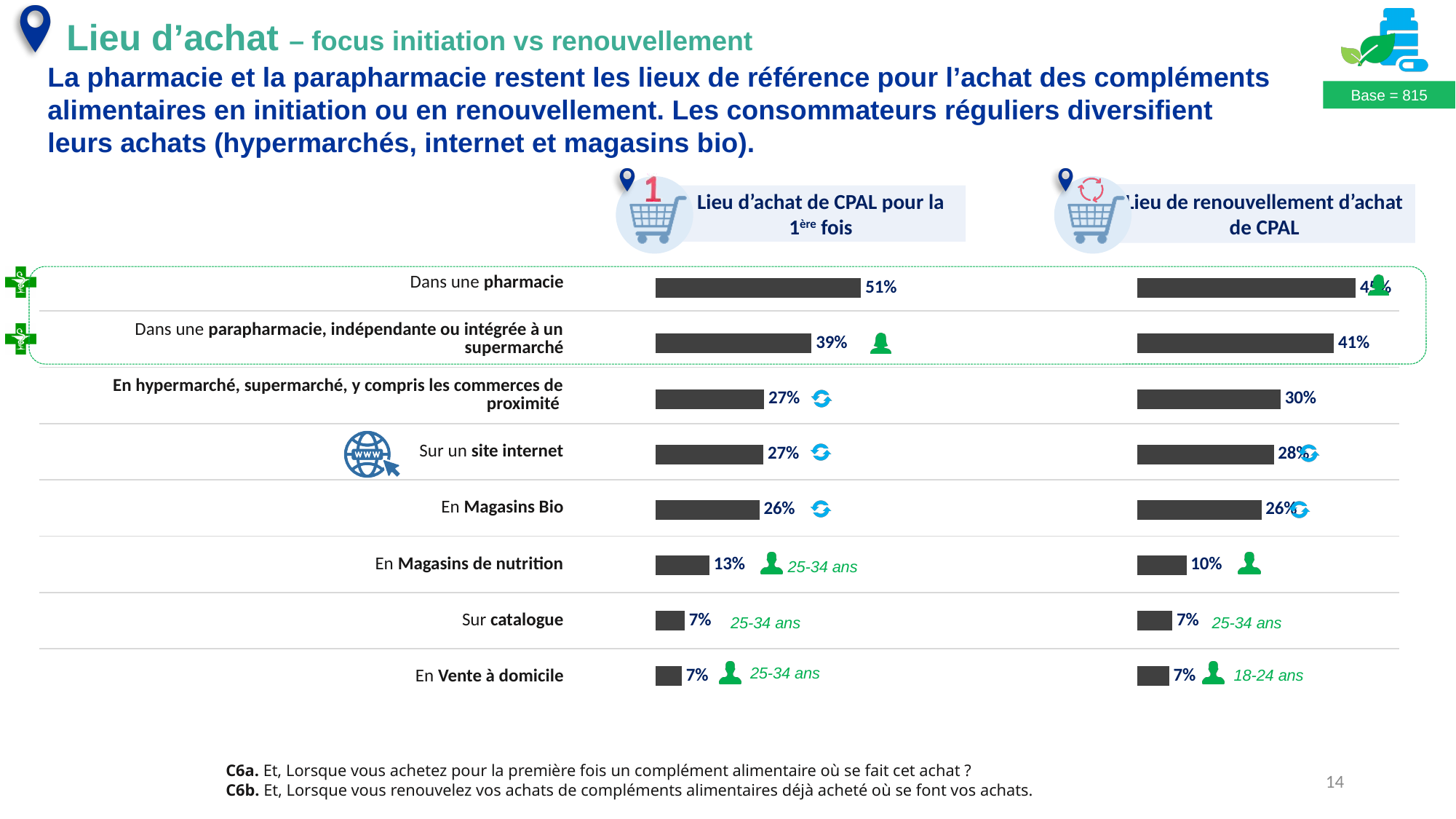
How many categories are shown in the 'Lieu d'achat de CPAL pour la 1ère fois' chart? 8 In the 'Lieu d'achat de CPAL pour la 1ère fois' chart, which category has the highest value? Dans une pharmacie In the 'Lieu d'achat de CPAL pour la 1ère fois' chart, what is the difference between 'Dans une pharmacie' and 'Dans une parapharmacie, indépendante ou intégrée à un supermarché'? 12% In the 'Lieu d'achat de CPAL pour la 1ère fois' chart, what is the value for 'Dans une pharmacie'? 51% In the 'Lieu de renouvellement d'achat de CPAL' chart, what is the value for 'En hypermarché, supermarché, y compris les commerces de proximité'? 30% In the 'Lieu de renouvellement d'achat de CPAL' chart, what is the difference between 'Sur un site internet' and 'En Magasins de nutrition'? 18% In the 'Lieu d'achat de CPAL pour la 1ère fois' chart, what is the value for 'En Magasins de nutrition'? 13% Which is larger: 'En hypermarché, supermarché, y compris les commerces de proximité' in the 'Lieu d'achat de CPAL pour la 1ère fois' chart or in the 'Lieu de renouvellement d'achat de CPAL' chart? Lieu de renouvellement d'achat de CPAL What is the base (number of respondents) shown on the slide? 815 In the 'Lieu de renouvellement d'achat de CPAL' chart, which category has the lowest value among those above 7%? En Magasins de nutrition What kind of chart is the 'Lieu de renouvellement d'achat de CPAL' chart? Bar chart In the 'Lieu de renouvellement d'achat de CPAL' chart, what is the value for 'Dans une parapharmacie, indépendante ou intégrée à un supermarché'? 41%